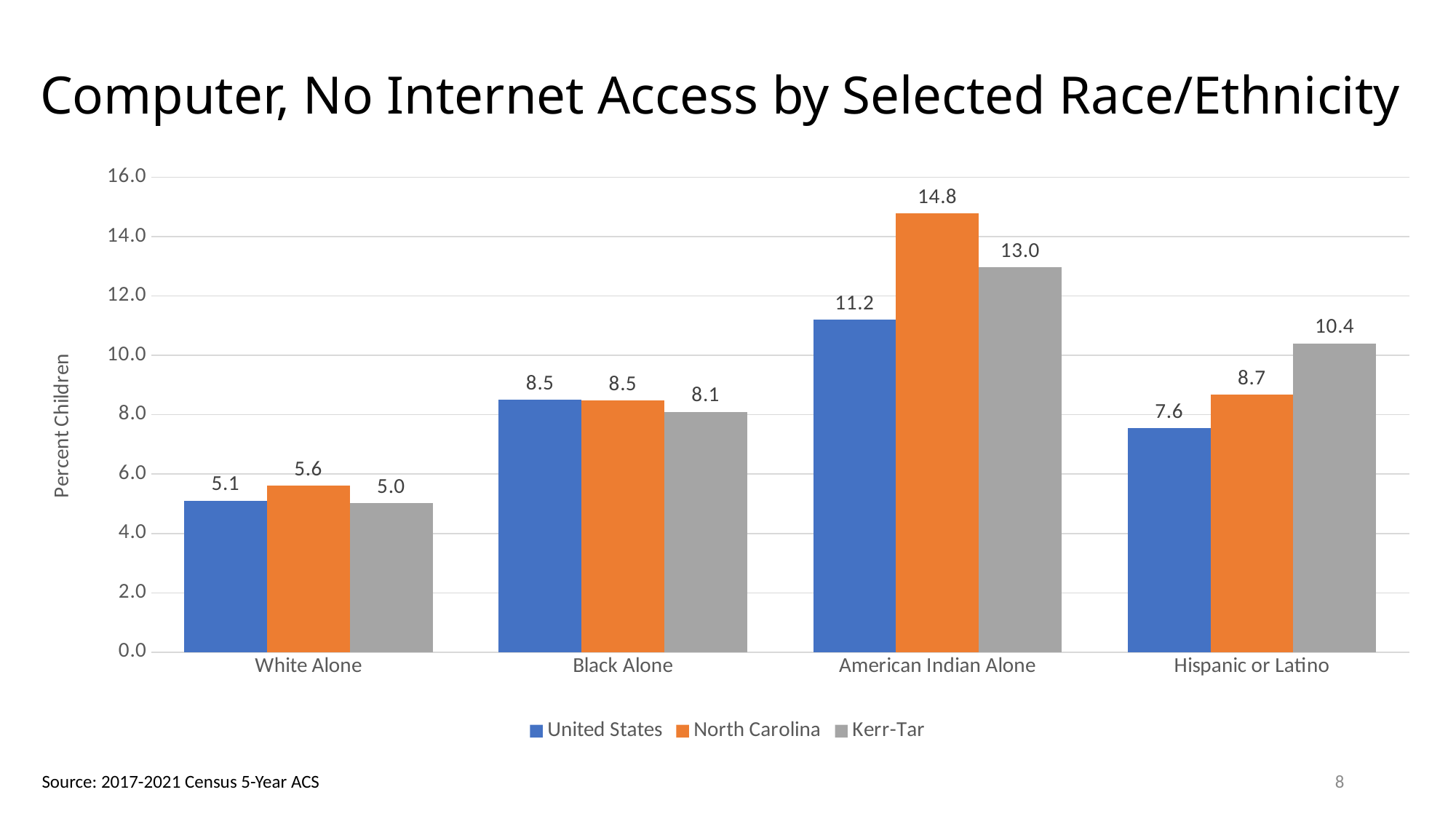
How many series does the legend list? 3 What is the value for United States in the White Alone category? 5.1 What is the difference between the North Carolina and United States values for American Indian Alone? 3.6 What kind of chart is shown on the slide? bar chart What is the label of the vertical axis? Percent Children What is the value for North Carolina in the Hispanic or Latino category? 8.7 Which category has the highest North Carolina value? American Indian Alone Which is larger for Hispanic or Latino: the Kerr-Tar value or the United States value? Kerr-Tar How many race/ethnicity categories are shown on the x axis? 4 What is the value for Kerr-Tar in the American Indian Alone category? 13.0 Is the Kerr-Tar value for Black Alone greater or less than 10.0? less Which category has the lowest Kerr-Tar value? White Alone